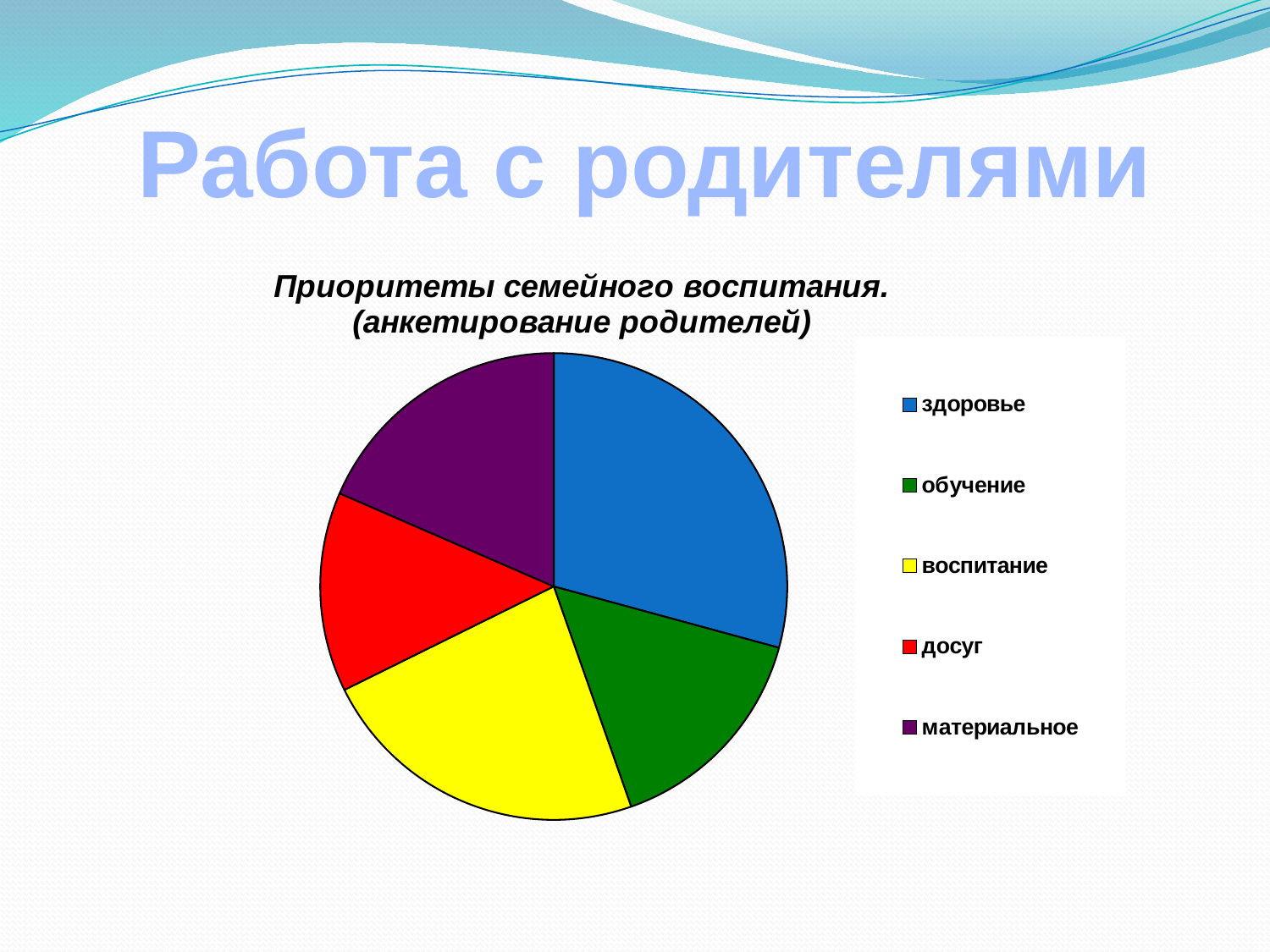
Which slice is larger, здоровье or материальное? здоровье What kind of chart is shown on the slide? pie chart Which slice is larger, воспитание or обучение? воспитание What is the title of the pie chart? Приоритеты семейного воспитания. (анкетирование родителей) Which colour represents the category досуг in the pie chart? red How many slices does the pie chart have? 5 Which category has the largest slice of the pie chart? здоровье Which slice is larger, воспитание or досуг? воспитание How many entries does the legend of the pie chart list? 5